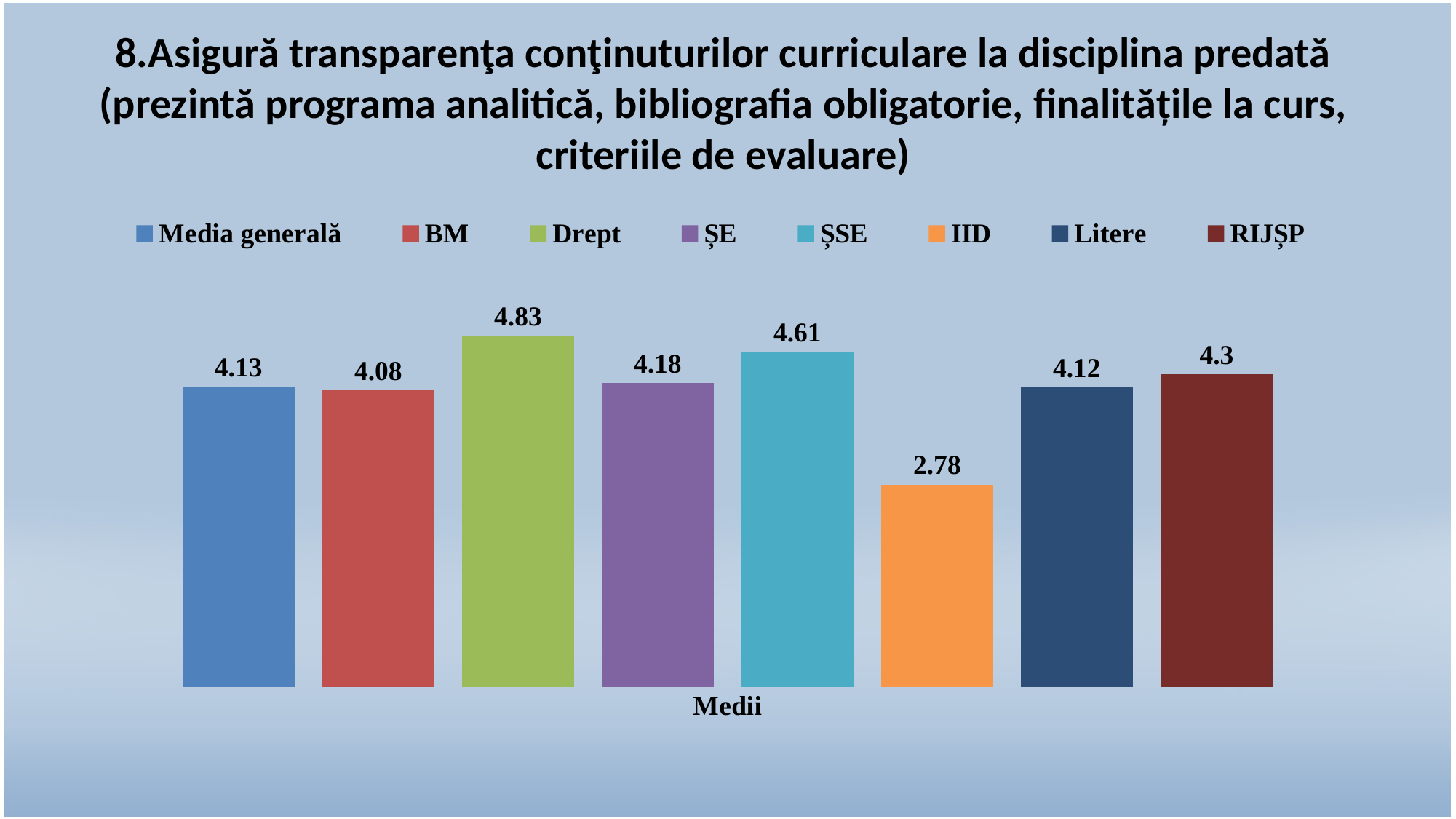
Which is larger, the value for ȘSE or the value for Litere? ȘSE How many series does the legend list? 8 What is the value for RIJȘP? 4.3 What is the label shown on the x axis below the bars? Medii What is the difference between the values for ȘSE and BM? 0.53 What is the value for Drept? 4.83 What is the difference between the values for Drept and IID? 2.05 What kind of chart is shown on the slide? Bar chart What is the value for Media generală? 4.13 What is the value for IID? 2.78 Which series has the highest value? Drept Which series has the lowest value? IID